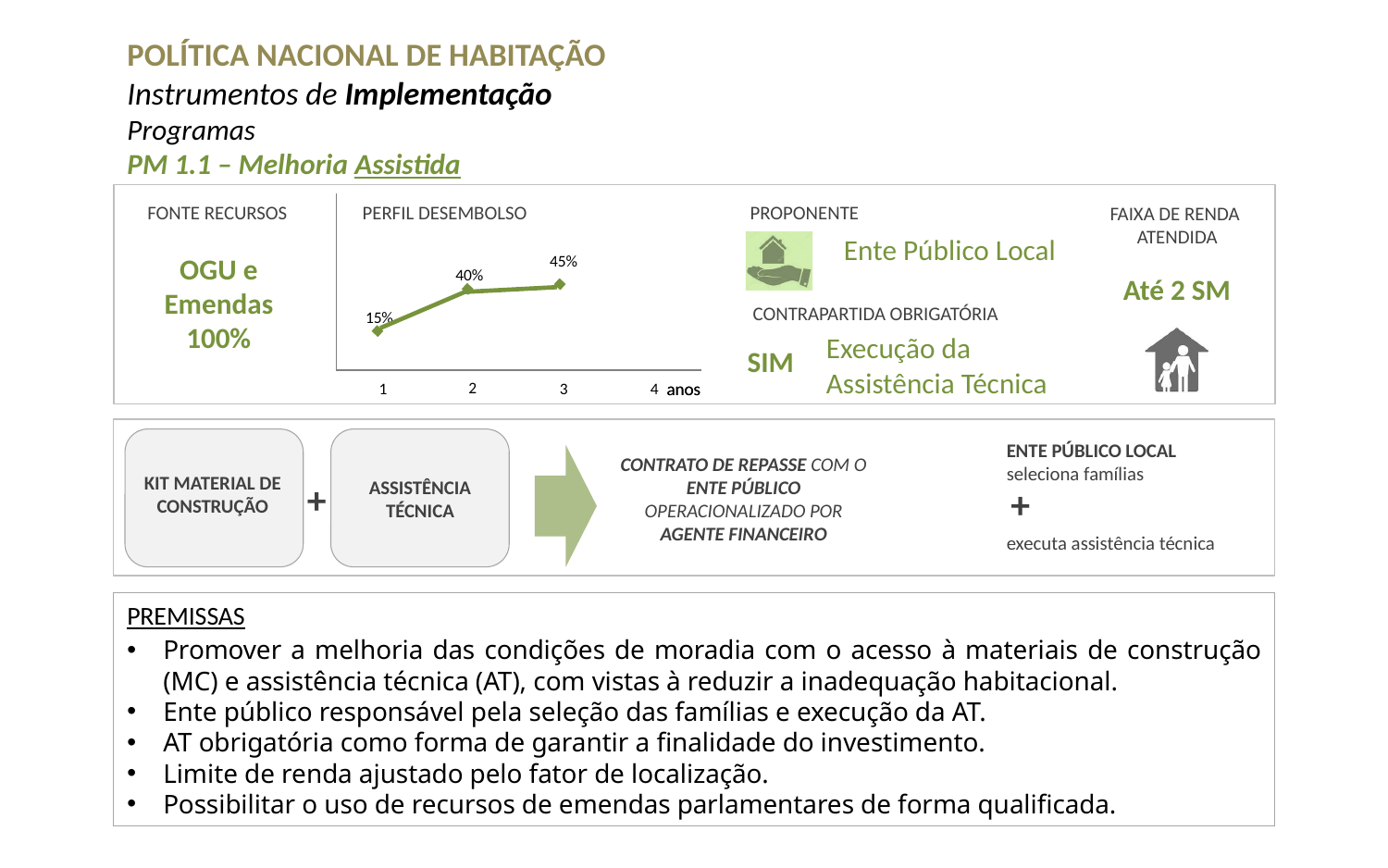
In the "PERFIL DESEMBOLSO" chart, which year has the lowest value? 1 What unit label appears at the end of the x axis of the "PERFIL DESEMBOLSO" chart? anos In the "PERFIL DESEMBOLSO" chart, is the value for year 2 larger or smaller than the value for year 1? larger In the "PERFIL DESEMBOLSO" chart, what is the value for year 1? 15% In the "PERFIL DESEMBOLSO" chart, do the values rise or fall from year 1 to year 3? rise In the "PERFIL DESEMBOLSO" chart, what is the value for year 2? 40% In the "PERFIL DESEMBOLSO" chart, what is the difference between the values for year 3 and year 2? 5% In the "PERFIL DESEMBOLSO" chart, which year has the highest value? 3 In the "PERFIL DESEMBOLSO" chart, what is the value for year 3? 45% How many data points are plotted in the "PERFIL DESEMBOLSO" chart? 3 In the "PERFIL DESEMBOLSO" chart, what is the difference between the values for year 2 and year 1? 25% What type of chart is shown under "PERFIL DESEMBOLSO"? line chart